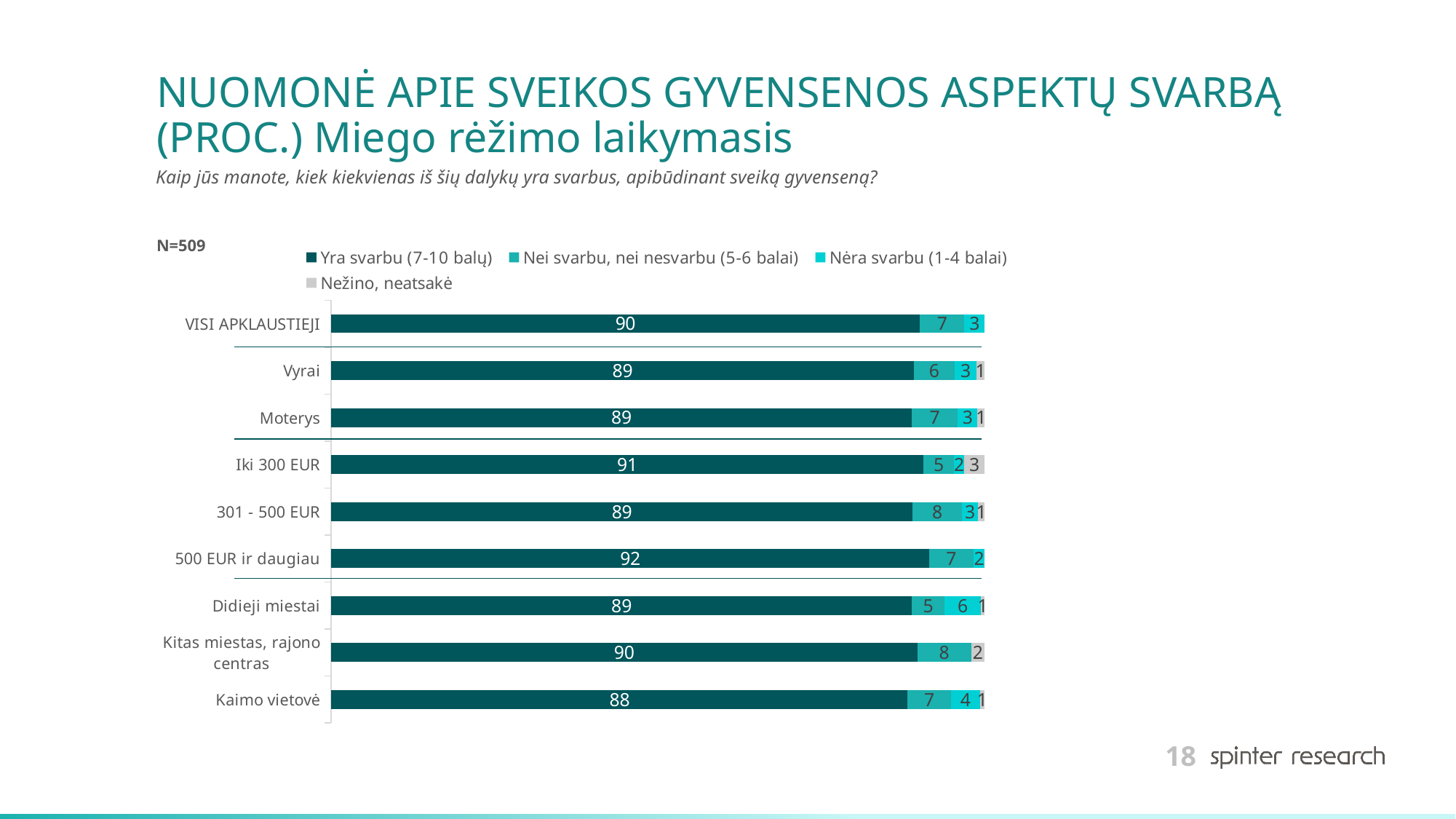
Which has a larger 'Nėra svarbu (1-4 balai)' value: Didieji miestai or Kaimo vietovė? Didieji miestai Which category has the lowest value for 'Yra svarbu (7-10 balų)'? Kaimo vietovė What sample size (N) is stated on the slide? N=509 What is the value of 'Yra svarbu (7-10 balų)' for VISI APKLAUSTIEJI? 90 What is the value of 'Nei svarbu, nei nesvarbu (5-6 balai)' for 301 - 500 EUR? 8 Which category has the highest value for 'Yra svarbu (7-10 balų)'? 500 EUR ir daugiau What is the difference between the 'Yra svarbu (7-10 balų)' values for 500 EUR ir daugiau and Kaimo vietovė? 4 What type of chart is shown on the slide? Stacked bar chart What is the value of 'Nėra svarbu (1-4 balai)' for Didieji miestai? 6 How many categories are plotted on the chart? 9 How many series does the legend list? 4 What is the value of 'Nežino, neatsakė' for Iki 300 EUR? 3